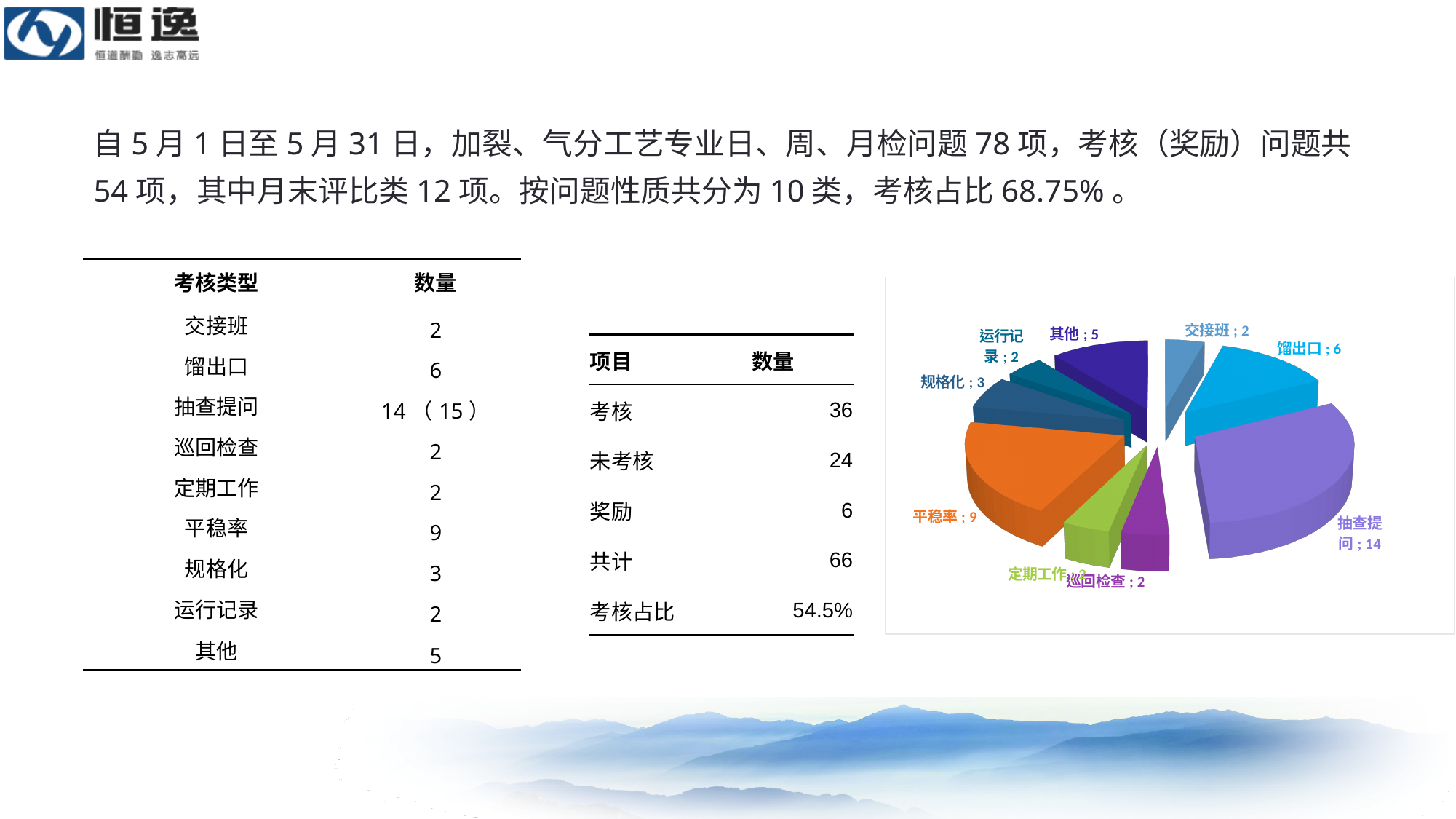
In the pie chart, what is the value for 规格化? 3 In the pie chart, which is larger: 馏出口 or 其他? 馏出口 In the pie chart, what is the value for 其他? 5 Which category has the largest slice in the pie chart? 抽查提问 What kind of chart is shown on the right side of the slide? pie chart What share of the pie chart total does 平稳率 represent? 20% In the pie chart, what is the value for 抽查提问? 14 In the pie chart, what is the value for 馏出口? 6 What colour is the 平稳率 slice in the pie chart? orange In the pie chart, what is the difference between the values for 抽查提问 and 平稳率? 5 In the pie chart, what is the value for 平稳率? 9 How many slices does the pie chart have? 9